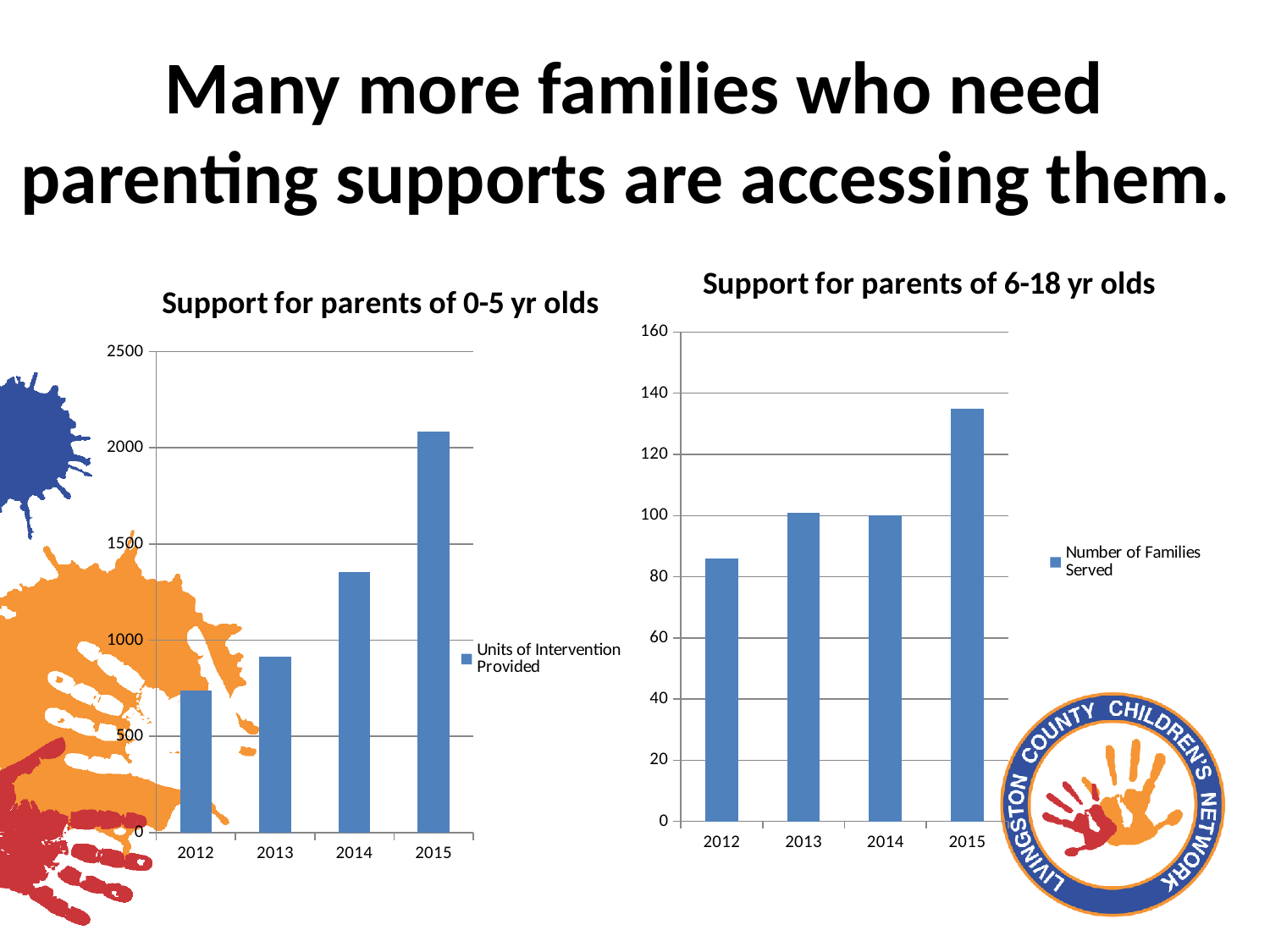
In the "Support for parents of 0-5 yr olds" chart, do the values rise or fall from 2012 to 2015? rise In the "Support for parents of 0-5 yr olds" chart, is the value for 2012 greater or less than 1000? less In the "Support for parents of 0-5 yr olds" chart, which year has the lowest value? 2012 In the "Support for parents of 6-18 yr olds" chart, which year has the lowest value? 2012 In the "Support for parents of 6-18 yr olds" chart, which is larger, the value for 2012 or the value for 2015? 2015 In the "Support for parents of 0-5 yr olds" chart, which year has the highest value? 2015 In the "Support for parents of 0-5 yr olds" chart, is the value for 2015 greater or less than 2000? greater In the "Support for parents of 6-18 yr olds" chart, is the value for 2015 greater or less than 120? greater How many years are shown on the x axis of the "Support for parents of 0-5 yr olds" chart? 4 In the "Support for parents of 6-18 yr olds" chart, which year has the highest value? 2015 What kind of chart is "Support for parents of 0-5 yr olds"? bar chart What series does the legend of the "Support for parents of 0-5 yr olds" chart list? Units of Intervention Provided